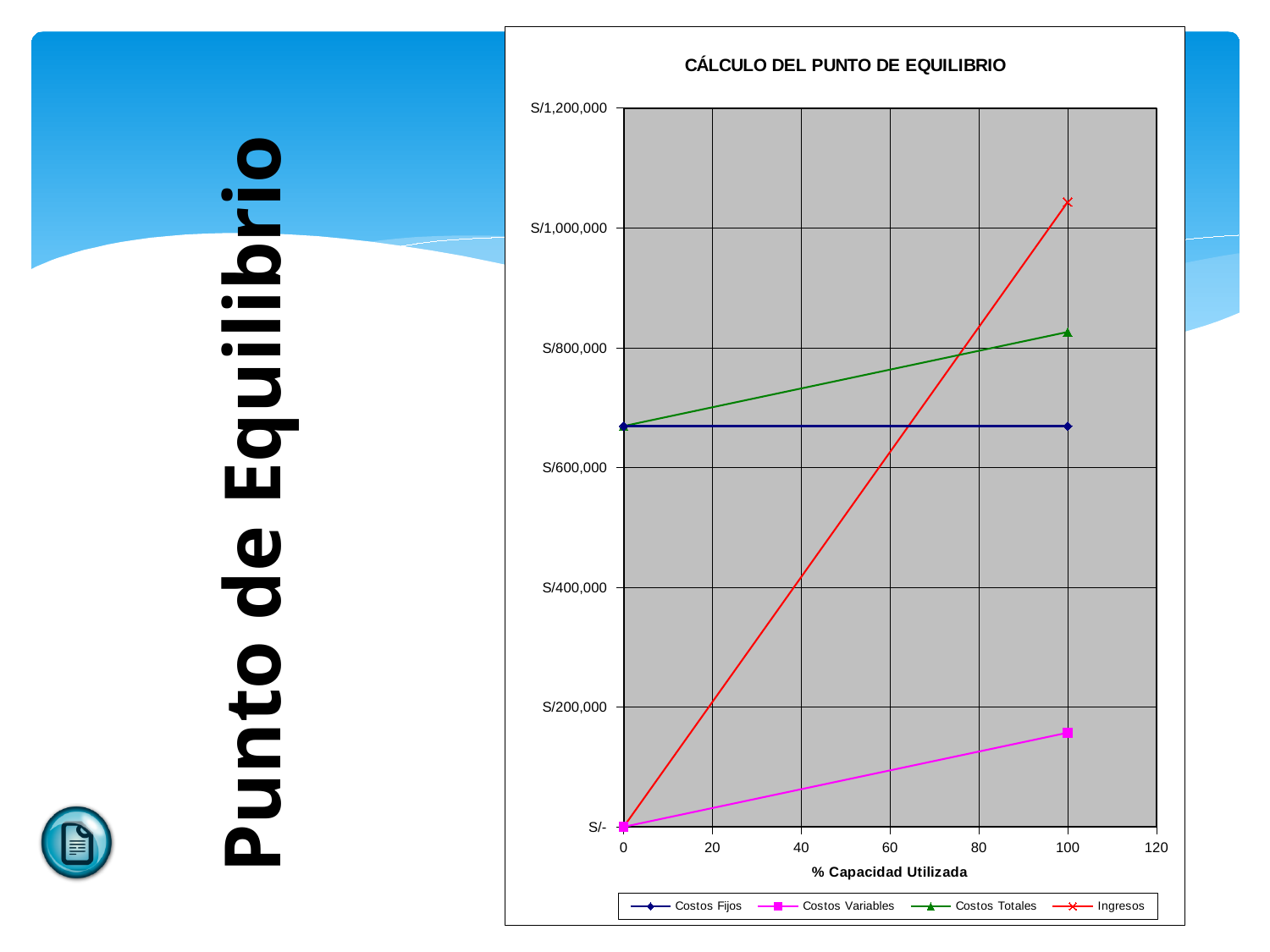
Is the value of Costos Variables at 100% capacity greater or less than S/200,000? less At 100% capacity, which is larger: Costos Totales or Costos Fijos? Costos Totales What is the title of the chart? CÁLCULO DEL PUNTO DE EQUILIBRIO Which series has the highest value at 100% capacity? Ingresos Is the value of Ingresos at 100% capacity greater or less than S/1,000,000? greater Does the Ingresos line rise or fall as % Capacidad Utilizada increases? rise How many series does the legend list? 4 Which series has the lowest value at 100% capacity? Costos Variables What is the value of Ingresos at 0% capacity? S/- What is the label of the x axis? % Capacidad Utilizada Is the value of Costos Fijos greater or less than S/600,000? greater What kind of chart is shown on the slide? line chart